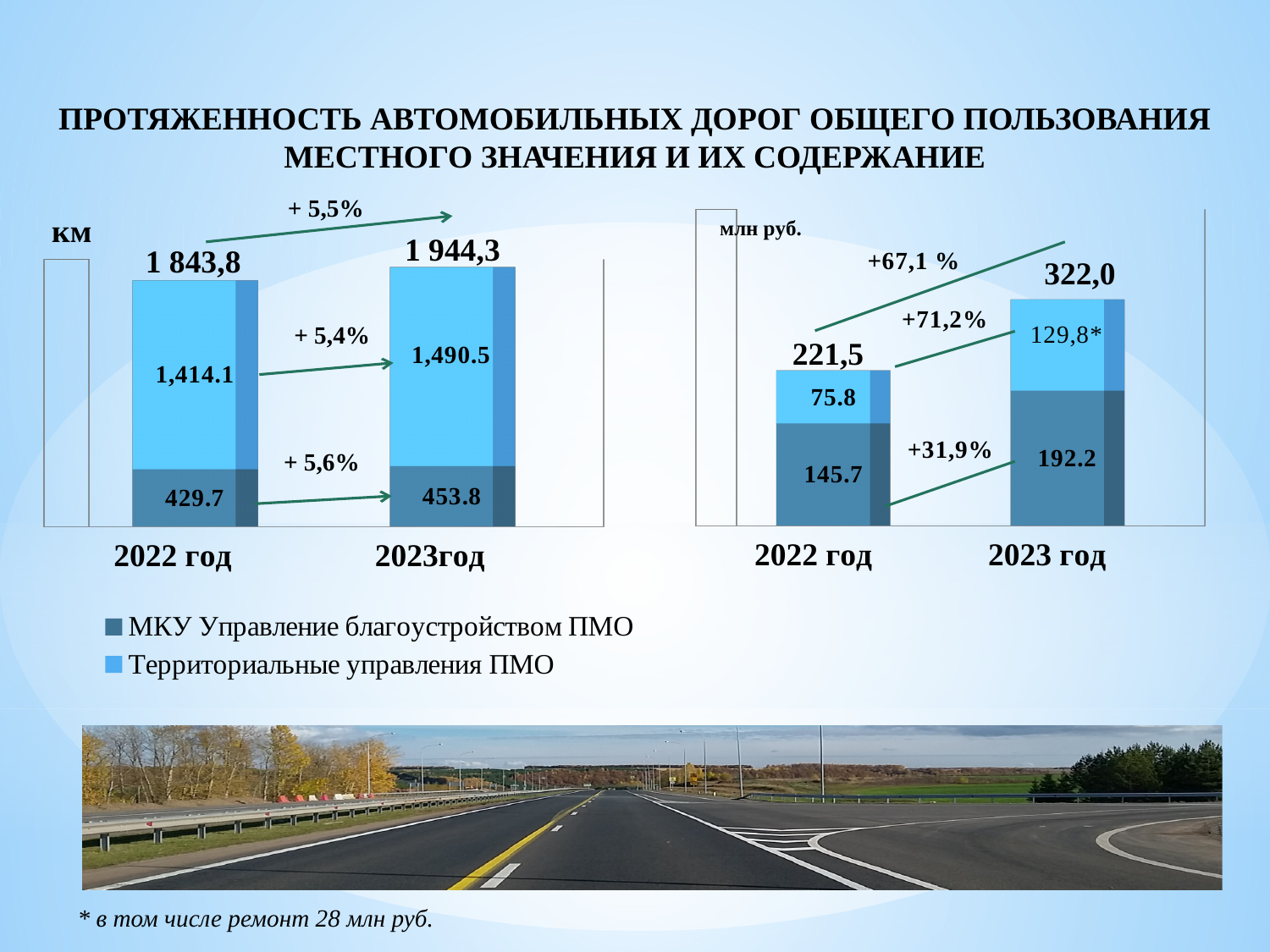
In the left chart (km), does the total rise or fall from 2022 год to 2023год? Rise In the right chart (млн руб.), what is the value for МКУ Управление благоустройством ПМО in 2023 год? 192.2 In the right chart (млн руб.), which year has the higher total? 2023 год In the right chart (млн руб.), what is the total of the stacked bar for 2022 год? 221,5 In the right chart (млн руб.), which is larger in 2022 год: МКУ Управление благоустройством ПМО or Территориальные управления ПМО? МКУ Управление благоустройством ПМО In the left chart (km), what is the value for Территориальные управления ПМО in 2023год? 1,490.5 What kind of chart is the left chart (km)? Stacked bar chart In the left chart (km), what is the total of the stacked bar for 2023год? 1 944,3 In the left chart (km), what is the value for МКУ Управление благоустройством ПМО in 2022 год? 429.7 How many series does the legend list? 2 In the left chart (km), what is the difference between the МКУ Управление благоустройством ПМО values for 2023год and 2022 год? 24.1 In the right chart (млн руб.), what is the value for Территориальные управления ПМО in 2022 год? 75.8